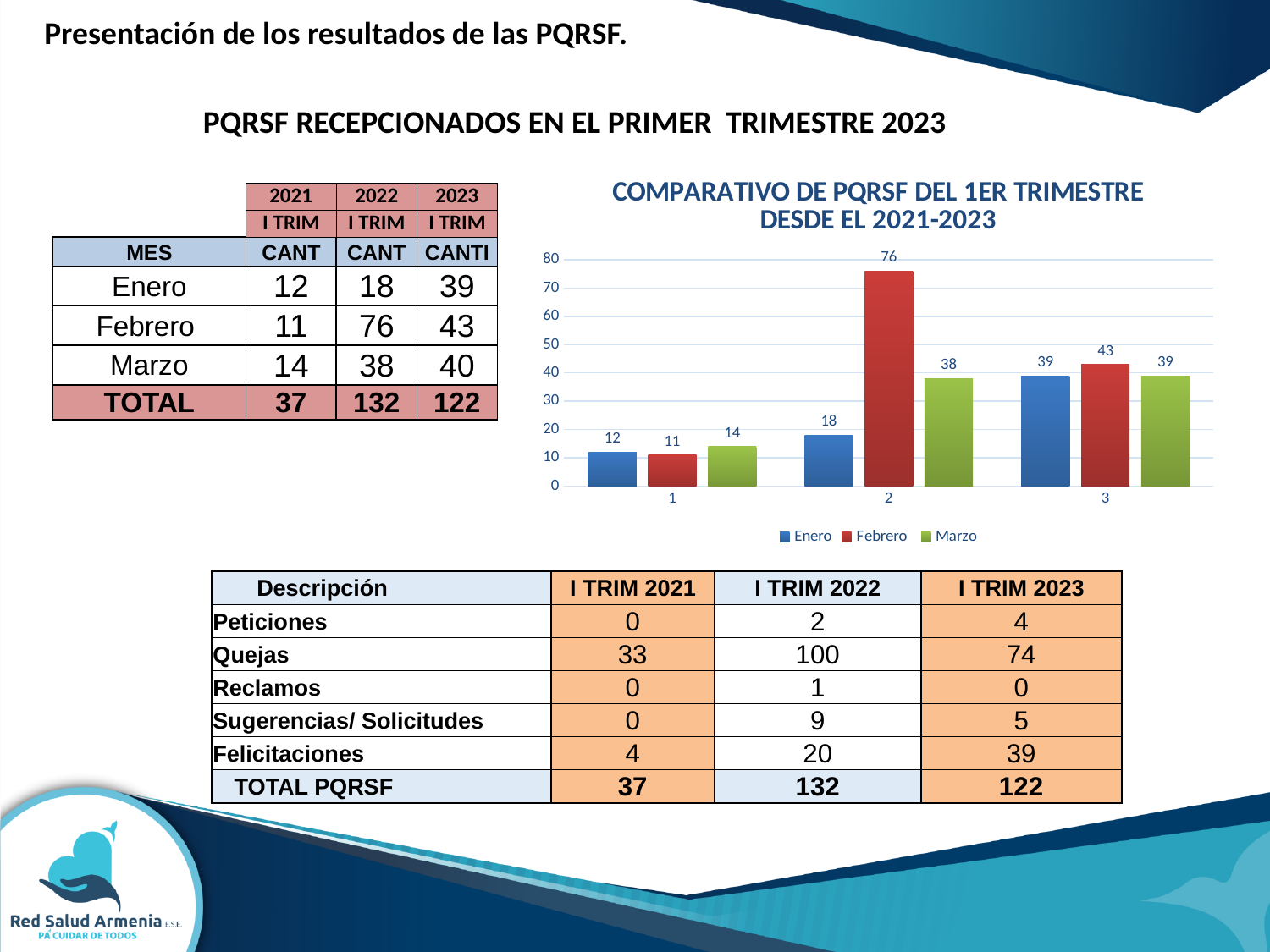
What is the difference between the Febrero and Marzo bars in category 2 of the chart? 38 What is the value of the Enero bar for category 3 in the chart? 39 What is the value of the Febrero bar for category 2 in the chart? 76 How many series does the chart's legend list? 3 What kind of chart is shown on the slide? bar chart How many categories are shown on the x axis of the chart? 3 What is the title of the chart on the slide? COMPARATIVO DE PQRSF DEL 1ER TRIMESTRE DESDE EL 2021-2023 In category 3 of the chart, which is larger, the Febrero bar or the Enero bar? Febrero What is the value of the Marzo bar for category 1 in the chart? 14 Which series has the lowest bar in category 1 of the chart? Febrero Is the value of the Febrero bar for category 2 greater or less than 70? greater Which series has the highest bar in category 2 of the chart? Febrero